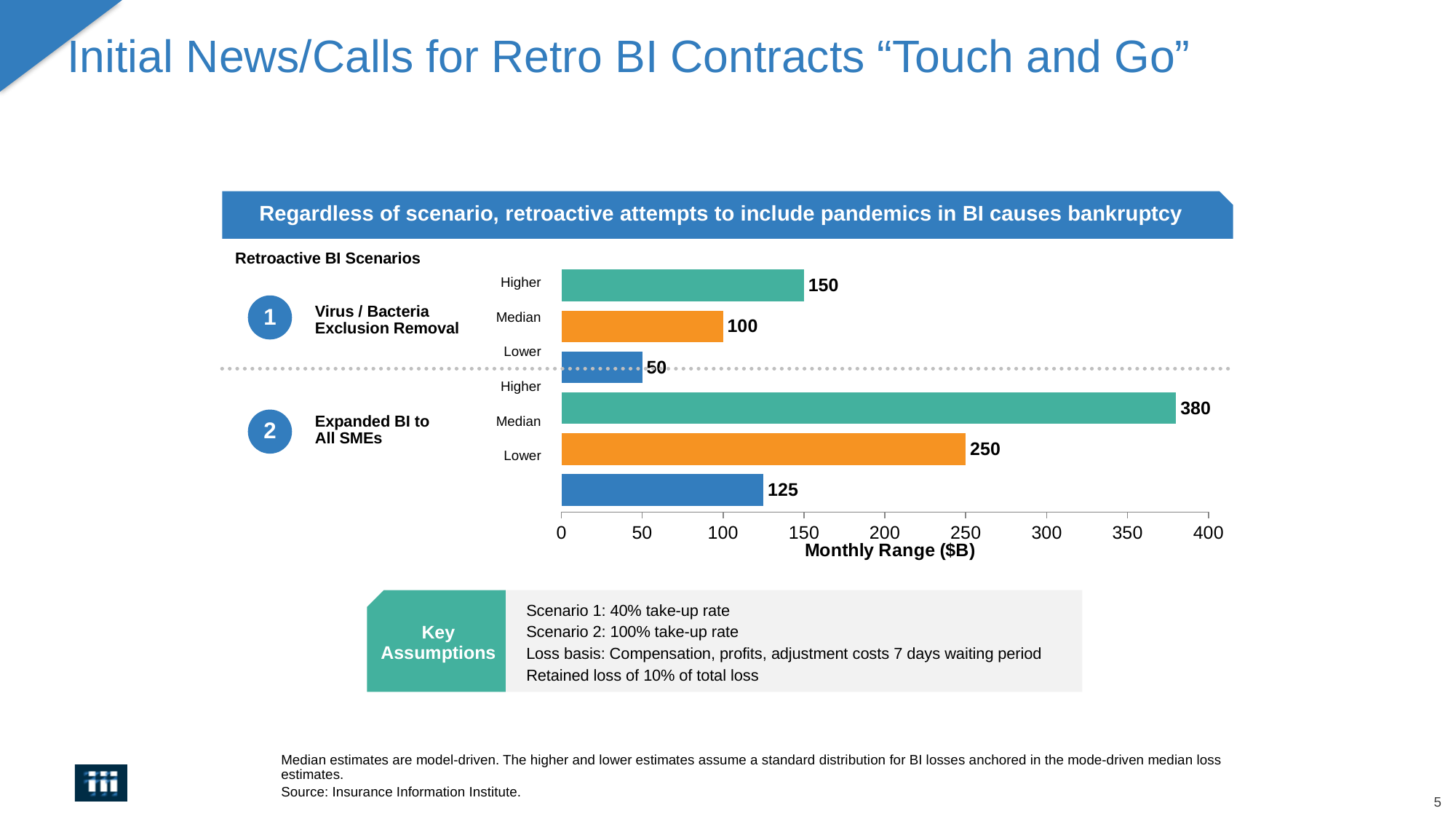
What is the Lower estimate for the Expanded BI to All SMEs scenario? 125 What is the difference between the Median and Lower estimates for the Virus / Bacteria Exclusion Removal scenario? 50 Which bar has the highest value on the chart? Expanded BI to All SMEs, Higher (380) What is the label of the x axis of the chart? Monthly Range ($B) What is the maximum value shown on the x axis of the chart? 400 Which is larger: the Median estimate for Expanded BI to All SMEs or the Higher estimate for Virus / Bacteria Exclusion Removal? Median estimate for Expanded BI to All SMEs Which bar has the lowest value on the chart? Virus / Bacteria Exclusion Removal, Lower (50) What is the difference between the Higher estimates of the Expanded BI to All SMEs scenario and the Virus / Bacteria Exclusion Removal scenario? 230 How many bars are plotted on the chart? 6 What is the Median estimate for the Expanded BI to All SMEs scenario? 250 What type of chart is shown on the slide? Bar chart What is the Higher estimate for the Virus / Bacteria Exclusion Removal scenario? 150